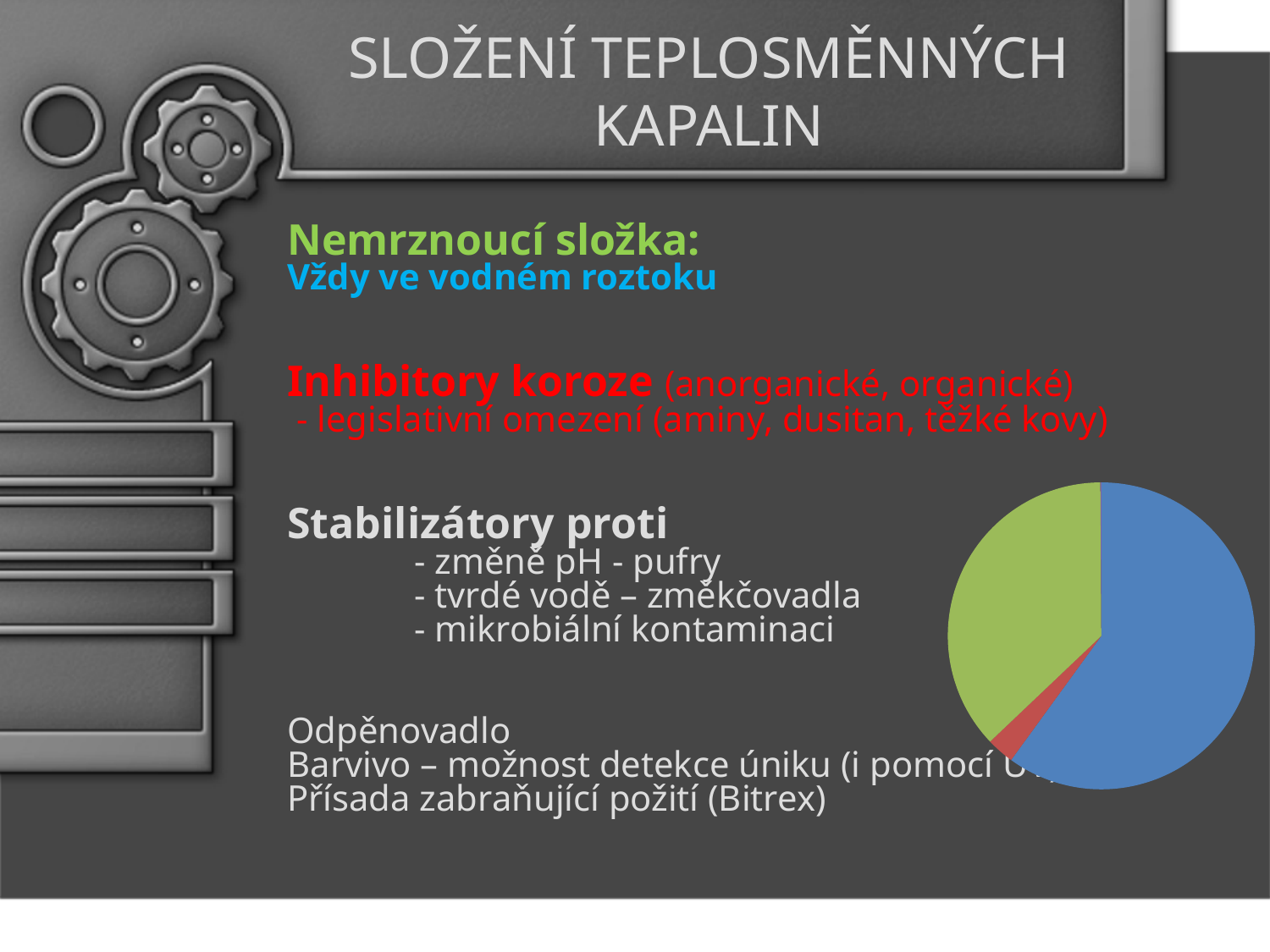
Which colour slice is the largest in the pie chart? blue Does the pie chart show a legend? no In the pie chart, which is larger, the blue slice or the green slice? blue In the pie chart, which is larger, the green slice or the red slice? green What kind of chart is shown on the slide? pie chart